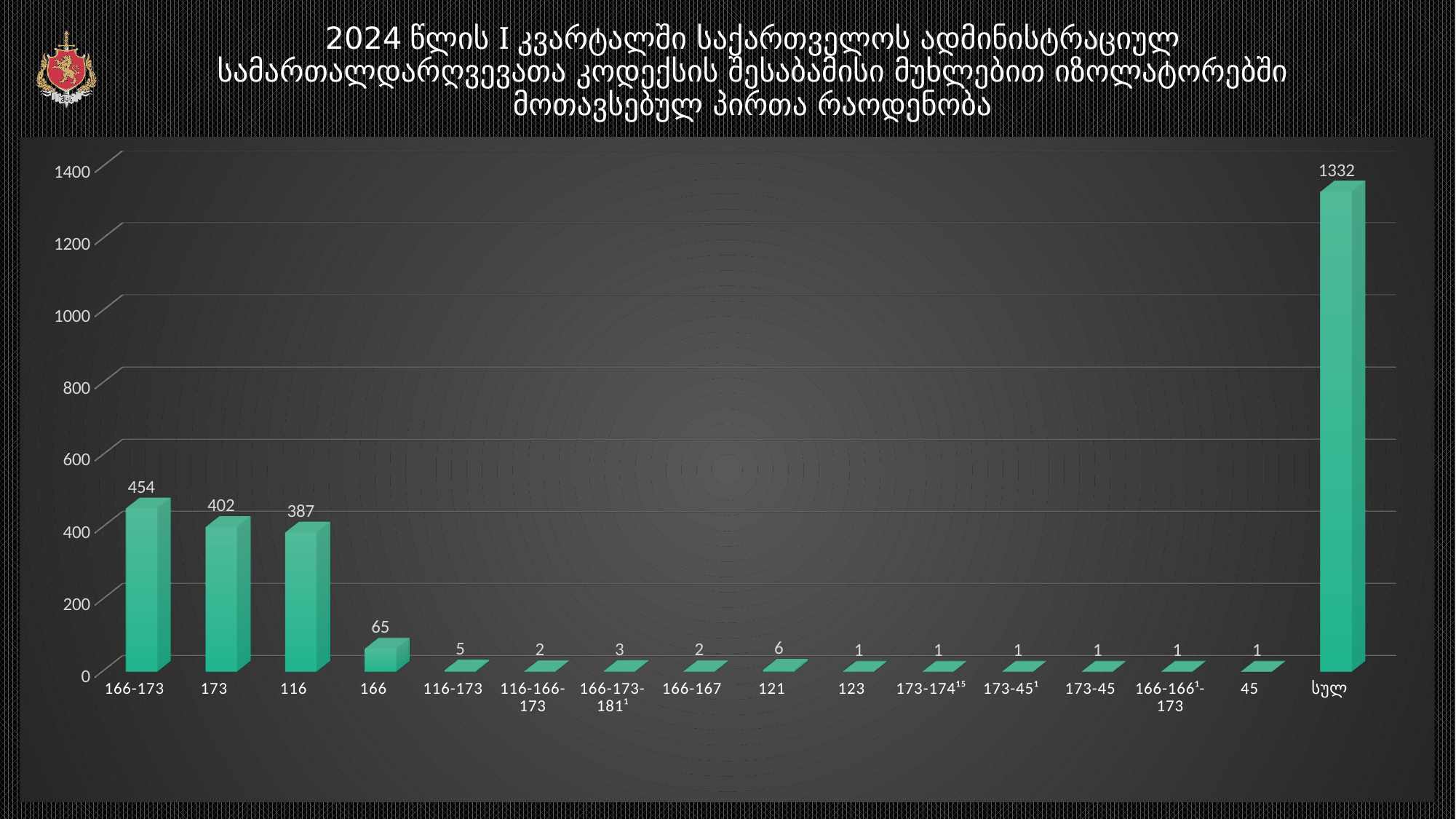
Is the value for "სულ" greater or less than 1200? greater Excluding the total bar "სულ", which category has the highest value? 166-173 What is the difference between the values for "166-173" and "173"? 52 What kind of chart is shown on the slide? bar chart Which is larger, the value for "121" or the value for "116-173"? 121 What value is shown for the category "173"? 402 What value is shown for the category "166"? 65 What value is shown for the category "116"? 387 How many categories are shown on the x axis of the chart? 16 What value is shown for the category "სულ"? 1332 What value is shown for the category "166-173"? 454 What is the difference between the values for "173" and "116"? 15